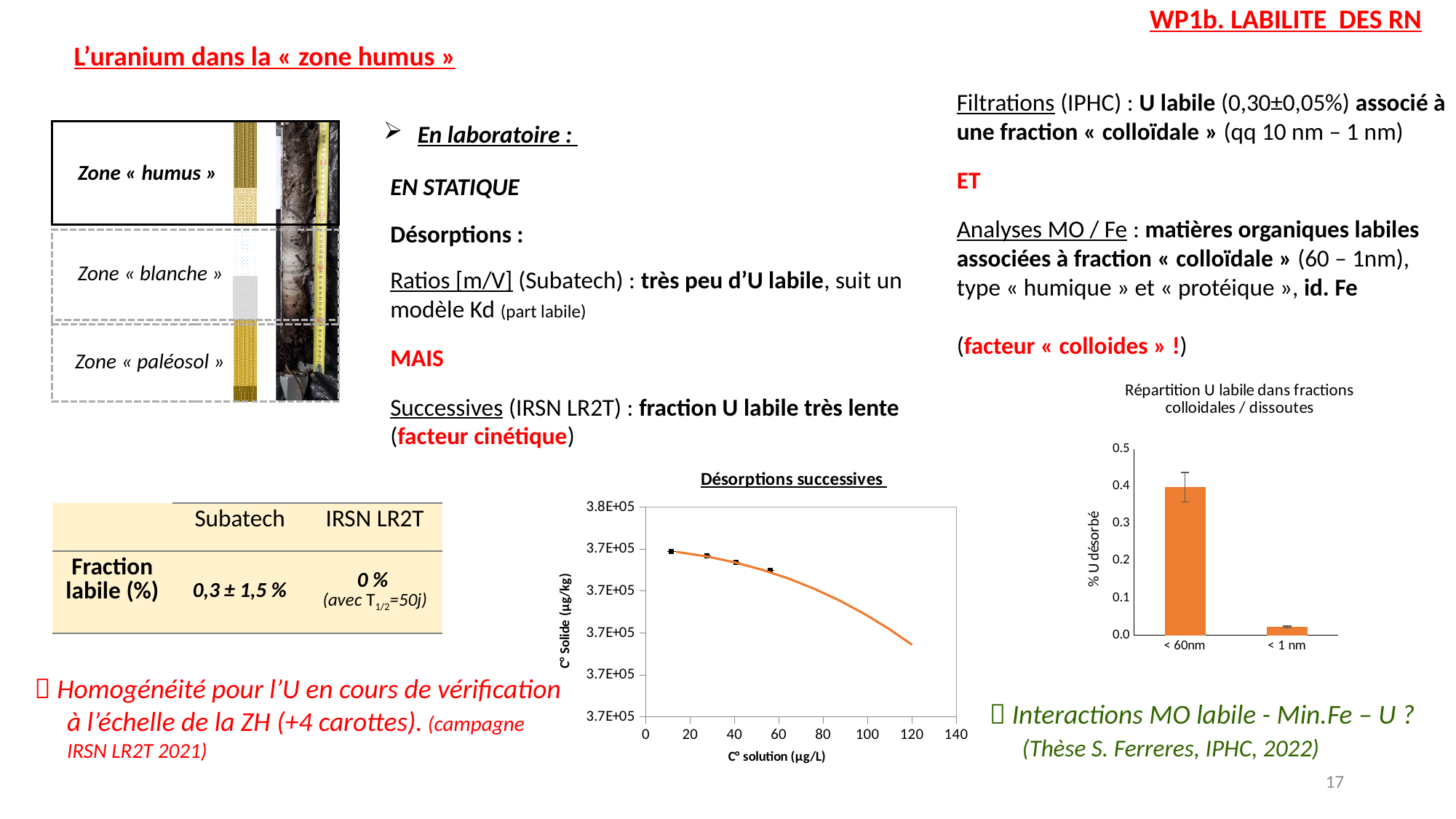
What kind of chart is the 'Répartition U labile dans fractions colloidales / dissoutes' chart? bar chart In the 'Répartition U labile dans fractions colloidales / dissoutes' chart, is the value for < 1 nm greater or less than 0.1? less In the 'Répartition U labile dans fractions colloidales / dissoutes' chart, which category has the highest value? < 60nm In the 'Répartition U labile dans fractions colloidales / dissoutes' chart, how many categories are shown on the x axis? 2 In the 'Répartition U labile dans fractions colloidales / dissoutes' chart, is the value for < 60nm greater or less than 0.3? greater In the 'Désorptions successives' chart, do the plotted values rise or fall as the x-axis value increases? fall In the 'Répartition U labile dans fractions colloidales / dissoutes' chart, which is larger, the value for < 60nm or the value for < 1 nm? < 60nm In the 'Désorptions successives' chart, what is the highest value shown on the x axis? 140 In the 'Désorptions successives' chart, how many data points are plotted? 4 What is the y-axis label of the 'Répartition U labile dans fractions colloidales / dissoutes' chart? % U désorbé In the 'Répartition U labile dans fractions colloidales / dissoutes' chart, which category has the lowest value? < 1 nm What is the x-axis label of the 'Désorptions successives' chart? C° solution (µg/L)